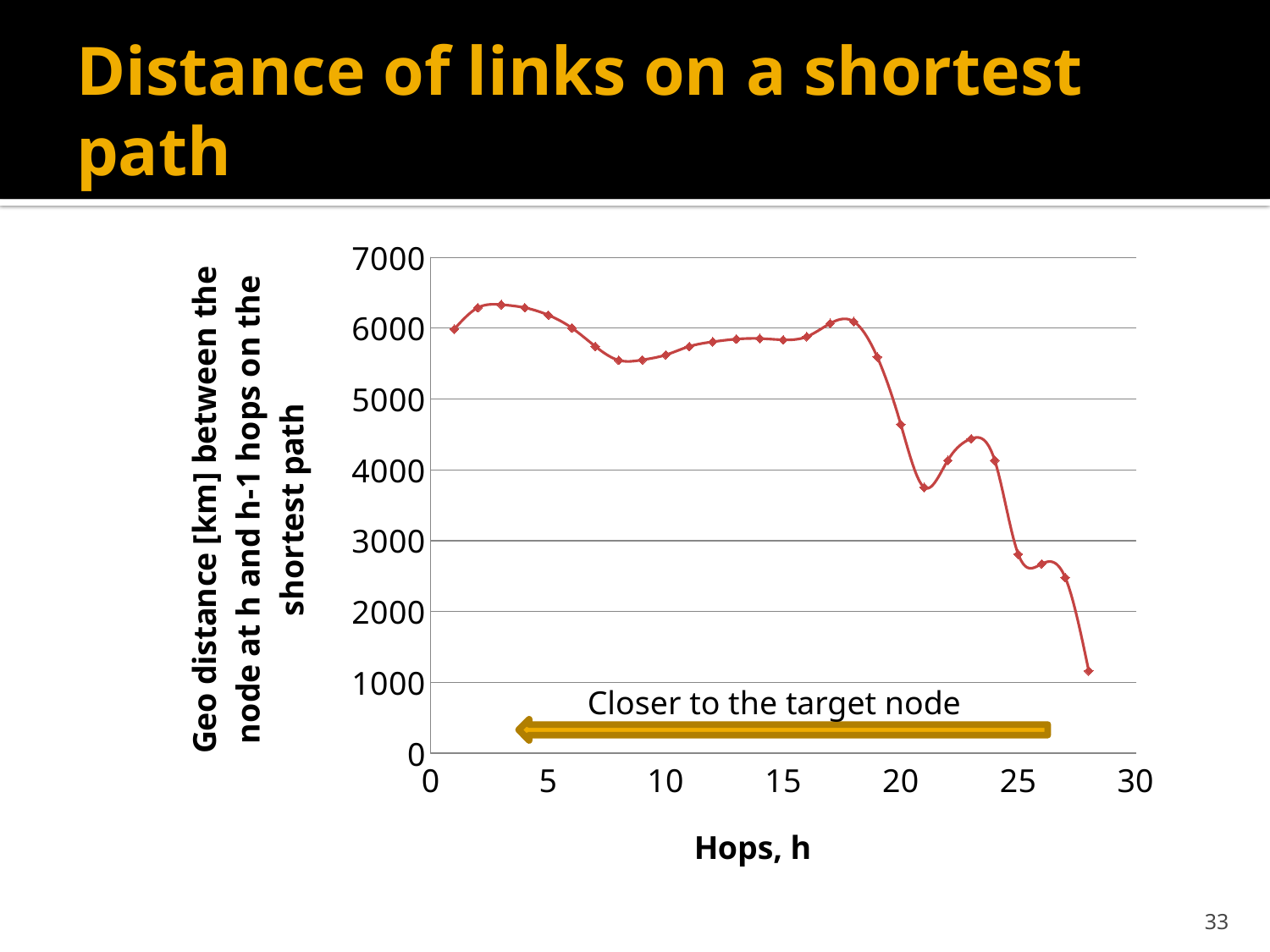
Which is larger, the value at 21 hops or the value at 23 hops? 23 hops Is the value at 28 hops greater or less than 2000? less What kind of chart is shown on the slide? line chart At which number of hops is the geo distance lowest? 28 Overall, do the values rise or fall as the number of hops increases along the x axis? fall What is the title of the x axis? Hops, h Is the value at 23 hops greater or less than 4000? greater Which is larger, the value at 1 hop or the value at 28 hops? 1 hop Is the value at 25 hops greater or less than 3000? less What text is written above the arrow inside the plot area? Closer to the target node